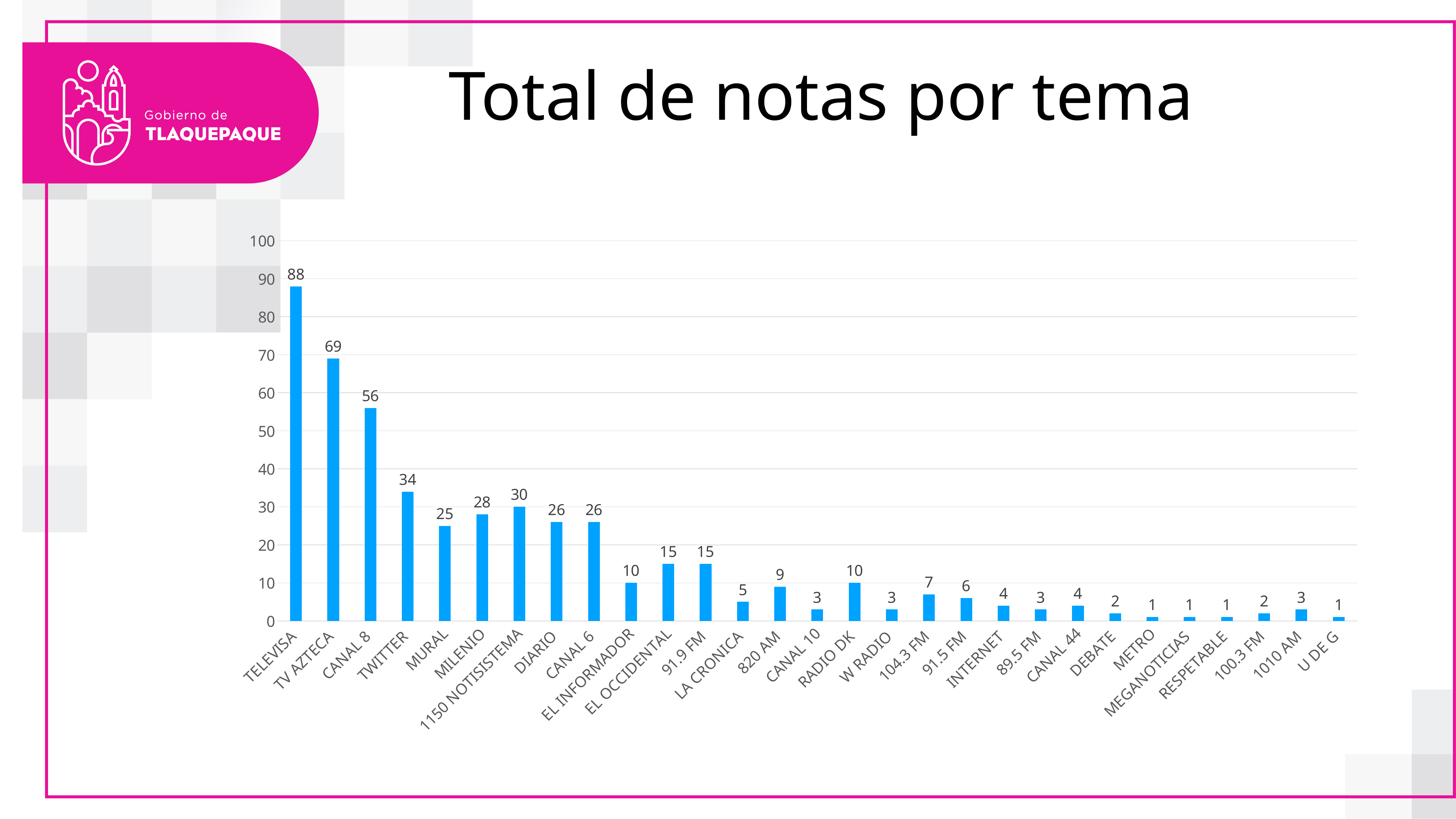
What kind of chart is shown on the slide? bar chart Which category has the highest value? TELEVISA What is the difference between the values for TV AZTECA and CANAL 8? 13 Which is larger, the value for MILENIO or the value for DIARIO? MILENIO Which is larger, the value for LA CRONICA or the value for 820 AM? 820 AM What is the value for 104.3 FM? 7 What is the title of the slide? Total de notas por tema How many categories are shown on the x axis? 29 What is the value for 1150 NOTISISTEMA? 30 What is the value for RADIO DK? 10 What is the difference between the values for TWITTER and MURAL? 9 What is the value for TELEVISA? 88